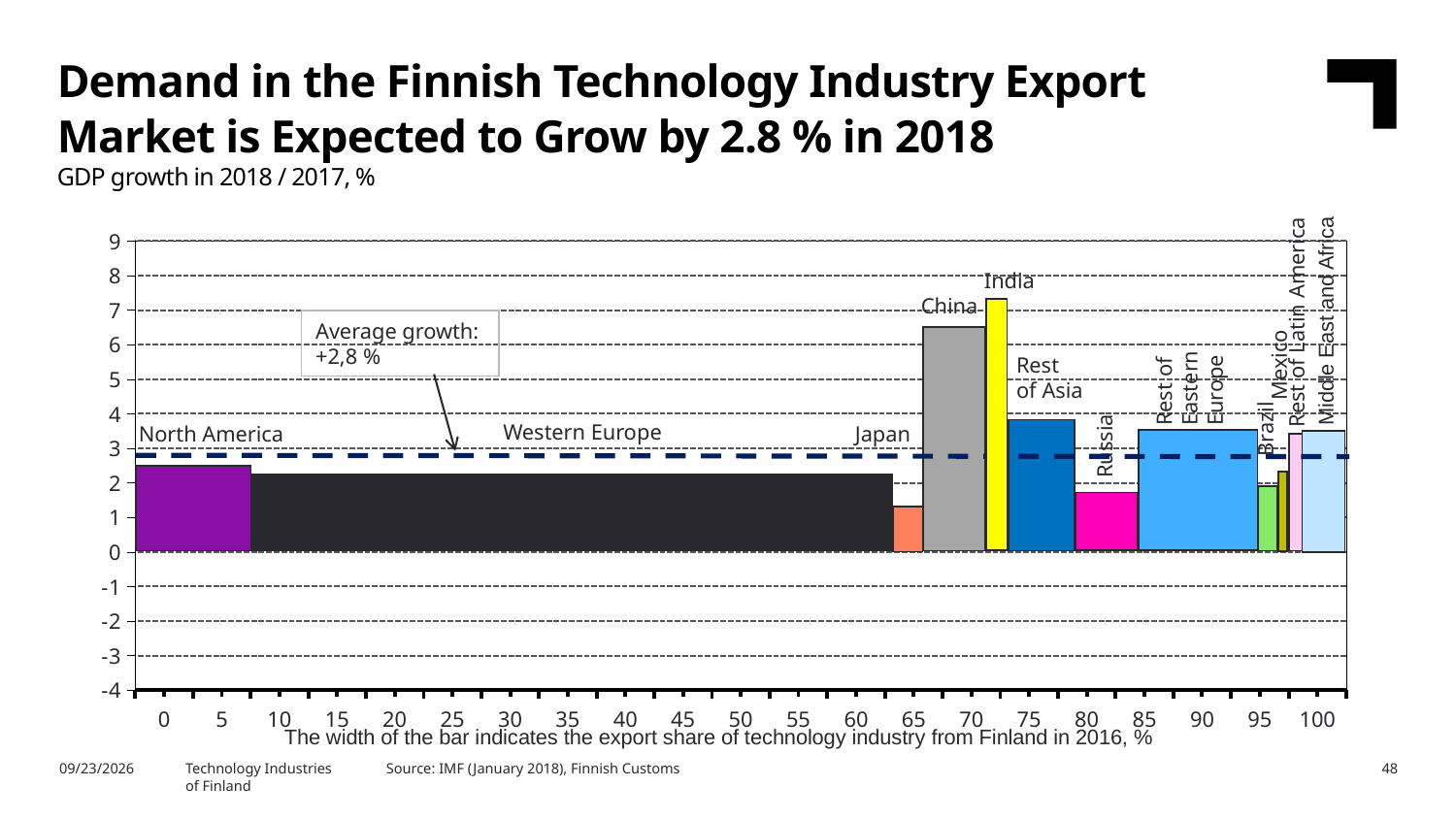
Is the GDP growth value for North America greater or less than 3? less Which has the higher GDP growth, North America or Japan? North America Is the GDP growth value for China greater or less than 5? greater Which region has the lowest GDP growth in the chart? Japan According to the note below the chart, what does the width of each bar indicate? The export share of technology industry from Finland in 2016, % Which has the higher GDP growth, China or Rest of Asia? China What average growth value is printed in the chart's annotation box? +2,8 % Which region has the highest GDP growth in the chart? India What kind of chart is shown on the slide? bar chart Is the GDP growth value for Japan greater or less than 2? less How many regions (bars) are shown in the chart? 12